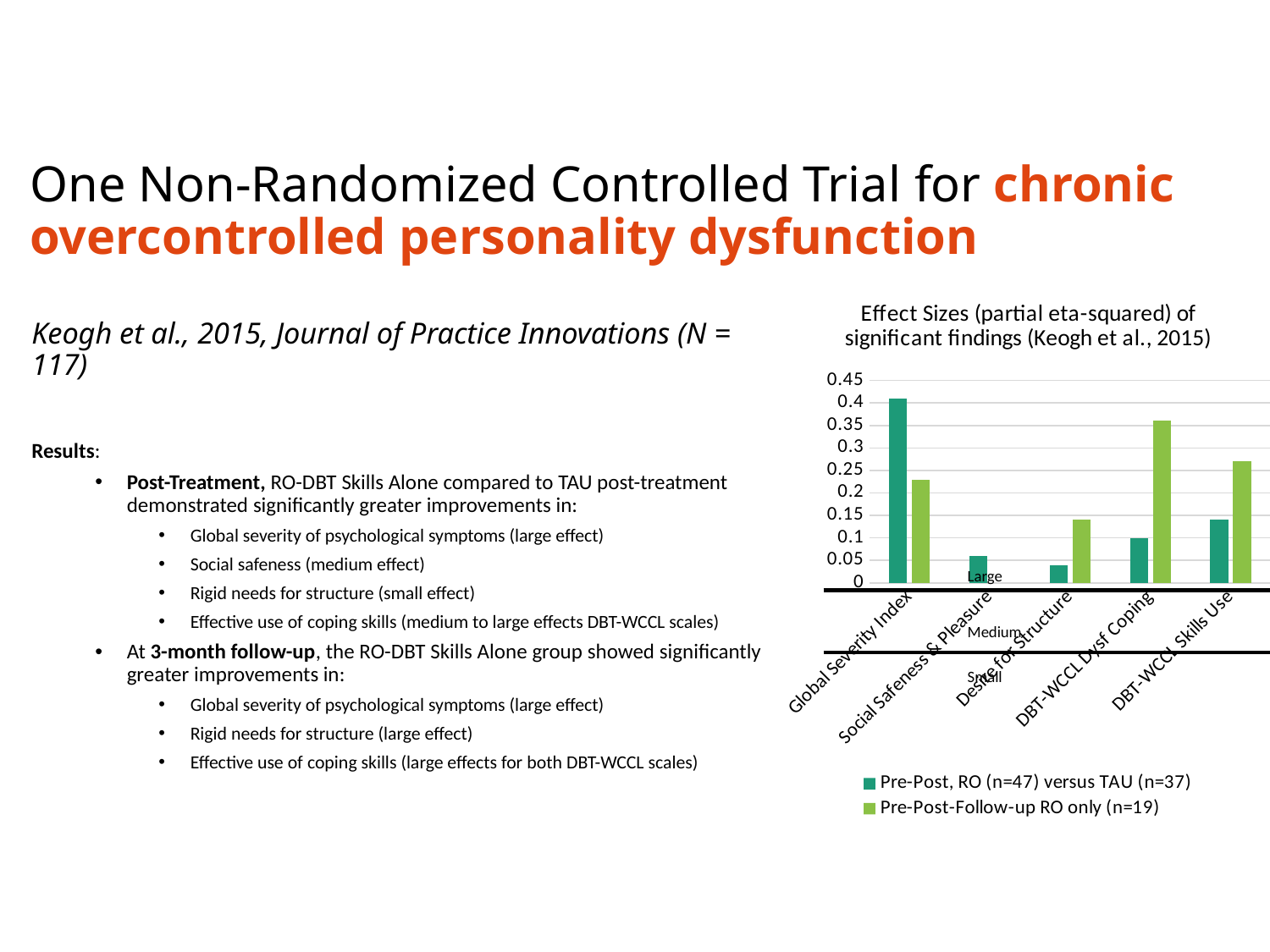
Which category has the highest value for the 'Pre-Post-Follow-up RO only (n=19)' series? DBT-WCCL Dysf Coping What is the title of the chart? Effect Sizes (partial eta-squared) of significant findings (Keogh et al., 2015) Is the 'Pre-Post-Follow-up RO only (n=19)' value for DBT-WCCL Dysf Coping greater or less than 0.3? greater Is the 'Pre-Post-Follow-up RO only (n=19)' value for DBT-WCCL Skills Use greater or less than 0.2? greater Is the 'Pre-Post, RO (n=47) versus TAU (n=37)' value for Global Severity Index greater or less than 0.3? greater How many categories are plotted along the x axis of the chart? 5 How many series does the chart's legend list? 2 For Global Severity Index, which series has the larger value? Pre-Post, RO (n=47) versus TAU (n=37) For DBT-WCCL Skills Use, which series has the larger value? Pre-Post-Follow-up RO only (n=19) What kind of chart is shown on the slide? bar chart Which category has the highest value for the 'Pre-Post, RO (n=47) versus TAU (n=37)' series? Global Severity Index